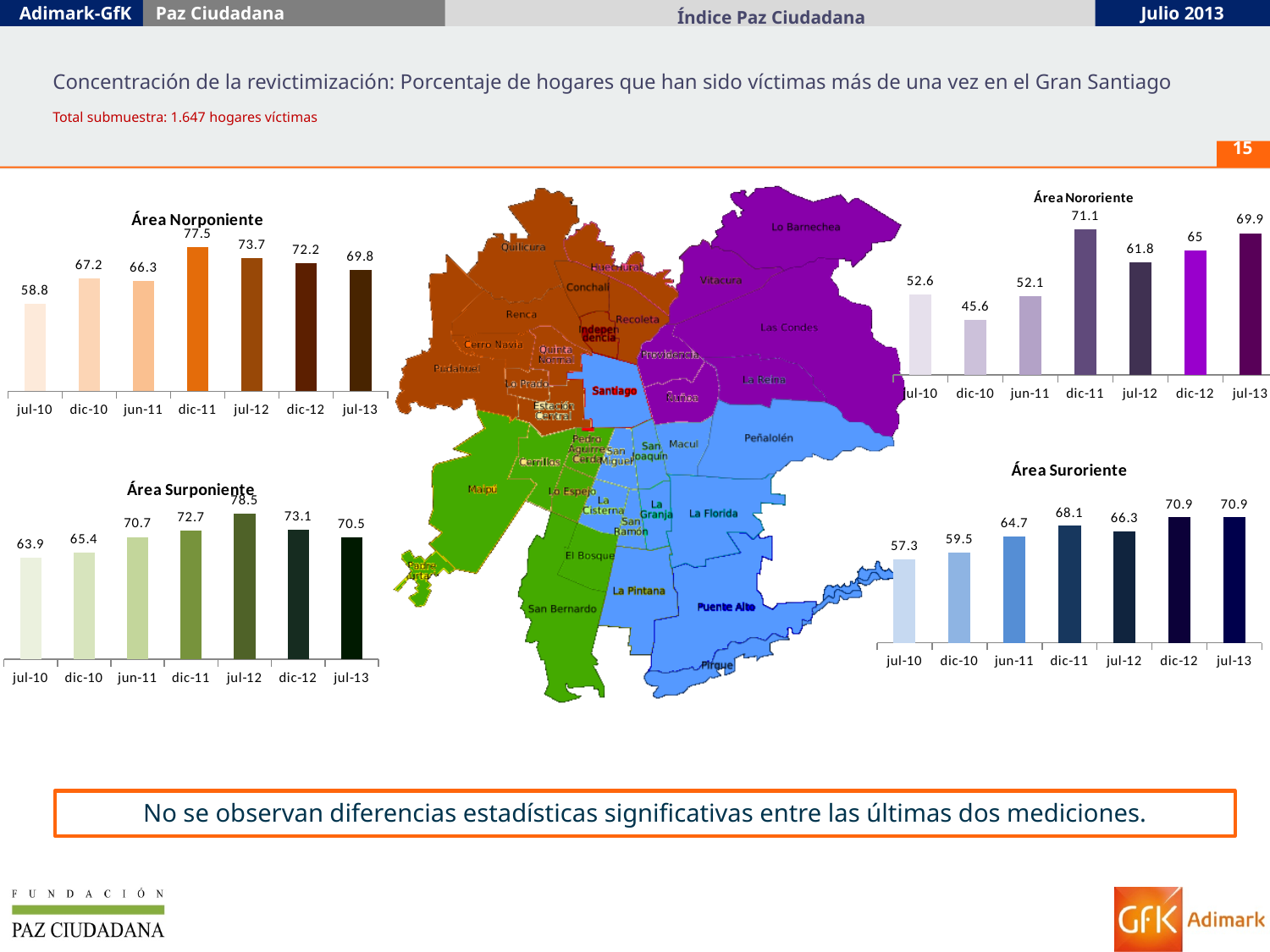
In the Área Norponiente chart, what is the value for dic-11? 77.5 In the Área Norponiente chart, which is larger, the value for dic-10 or the value for jun-11? dic-10 How many bar charts are shown on the slide? 4 In the Área Nororiente chart, what is the difference between the jul-13 value and the jul-12 value? 8.1 In the Área Suroriente chart, what is the difference between the jul-10 value and the dic-10 value? 2.2 In the Área Nororiente chart, which period has the lowest value? dic-10 In the Área Surponiente chart, do the values rise or fall from jul-10 to dic-11? Rise What type of chart is the Área Surponiente chart? Bar chart In the Área Surponiente chart, which period has the highest value? jul-12 How many periods are shown on the x axis of the Área Suroriente chart? 7 In the Área Nororiente chart, what is the value for dic-12? 65 In the Área Suroriente chart, what is the value for jul-13? 70.9